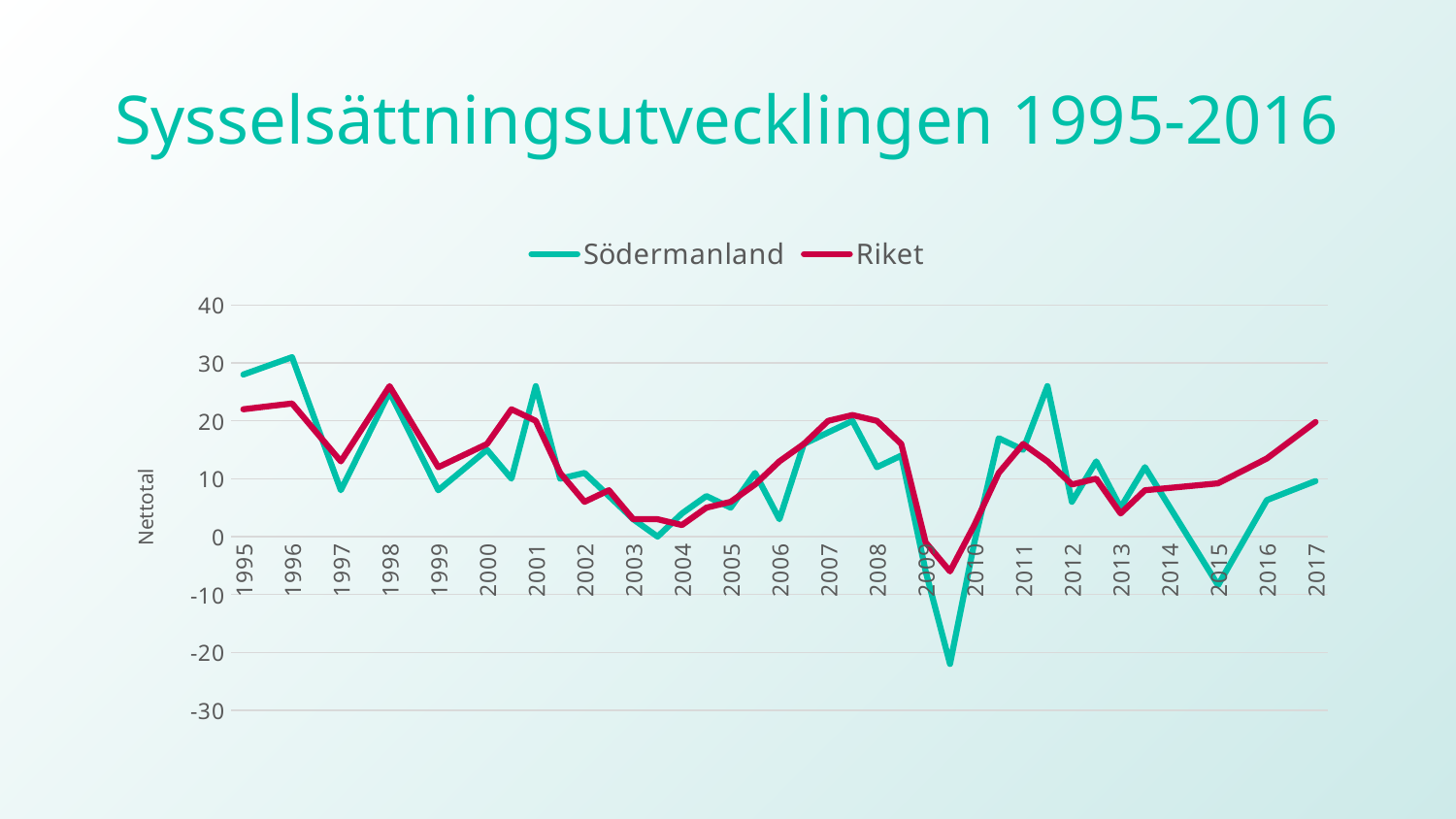
What kind of chart is shown on the slide? line chart What are the two series named in the legend? Södermanland and Riket Is the value for Riket in 1998 greater or less than 20? greater How many series does the legend list? 2 What is the label on the vertical axis? Nettotal Is the lowest value for Riket greater or less than 0? less Around which year does the Södermanland line reach its lowest point? 2009 Is the value for Södermanland in 2015 greater or less than 0? less In 1995, which series has the higher value, Södermanland or Riket? Södermanland In 2016, which series has the higher value, Södermanland or Riket? Riket